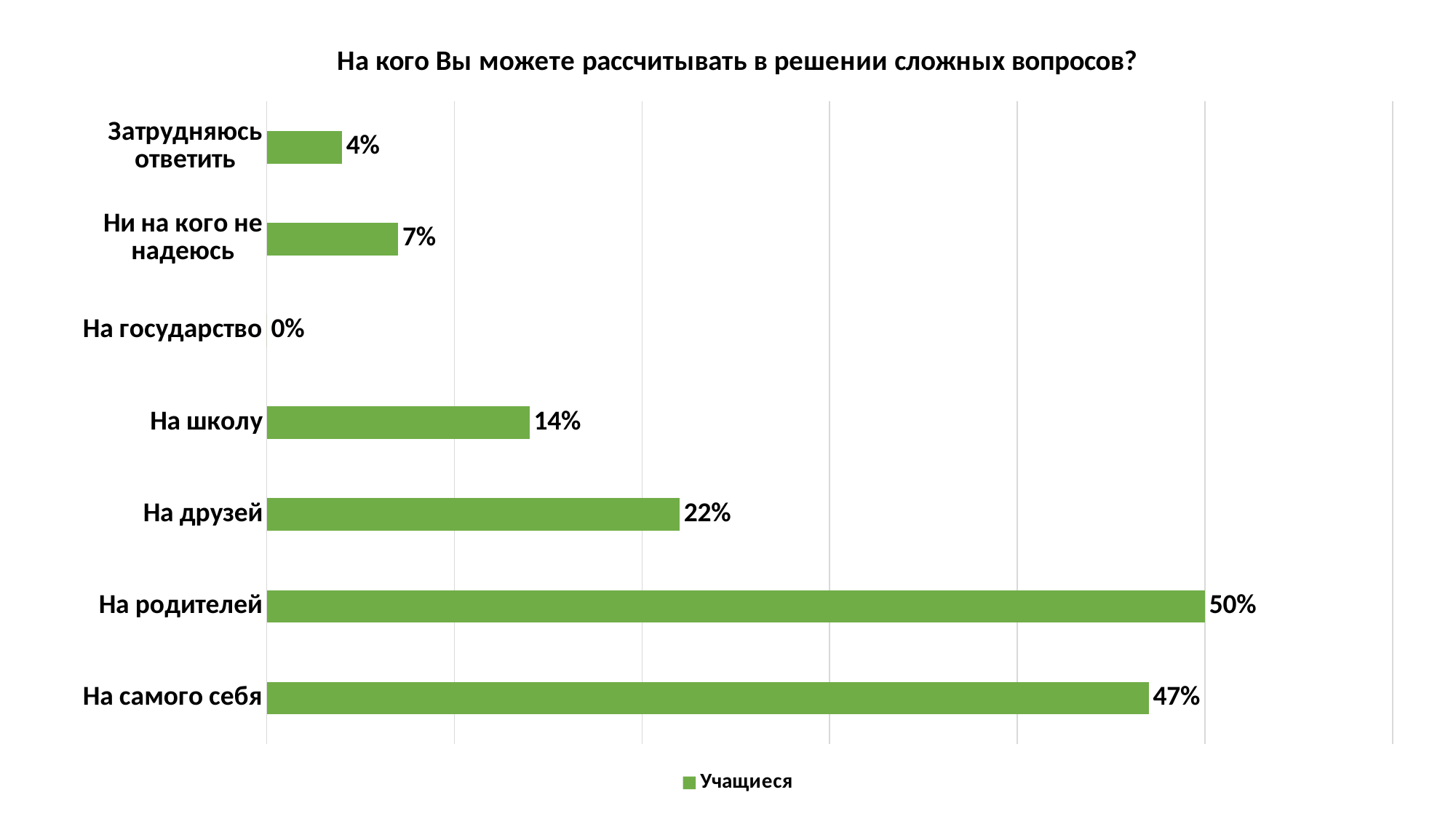
What is the value shown for "На государство"? 0% How many series does the legend list? 1 What is the difference between the values for "На друзей" and "На школу"? 8% What percentage of respondents chose "На родителей"? 50% Which category has the highest value? На родителей How many categories are shown in the chart? 7 Which category has the lowest value? На государство Which is larger, the value for "На друзей" or the value for "Ни на кого не надеюсь"? На друзей What is the name of the series shown in the legend? Учащиеся What is the difference between the values for "На родителей" and "На самого себя"? 3% What kind of chart is shown on the slide? Bar chart What is the value shown for "На школу"? 14%